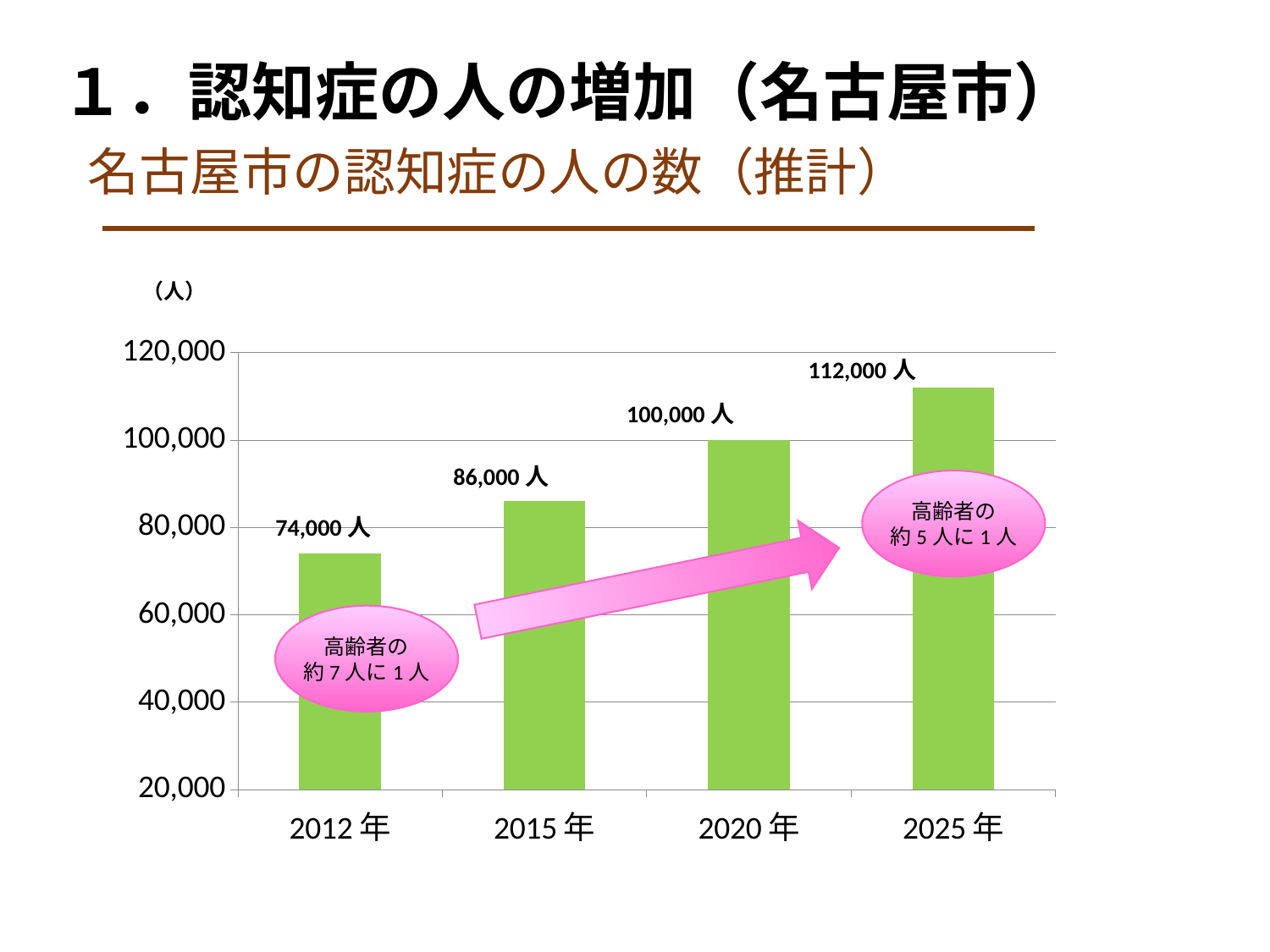
What is the estimated number of people with dementia in Nagoya in 2012年? 74,000人 What kind of chart is shown on the slide? Bar chart What is the estimated number of people with dementia in Nagoya in 2020年? 100,000人 Which year has the highest estimated number of people with dementia? 2025年 What is the difference between the estimated number for 2025年 and 2012年? 38,000人 Which is larger, the value for 2015年 or the value for 2020年? 2020年 Do the values rise or fall from 2012年 to 2025年? Rise How many years are shown on the x axis of the chart? 4 What is the estimated number of people with dementia in Nagoya in 2025年? 112,000人 What is the estimated number of people with dementia in Nagoya in 2015年? 86,000人 Which year has the lowest estimated number of people with dementia? 2012年 What is the difference between the estimated number for 2020年 and 2015年? 14,000人